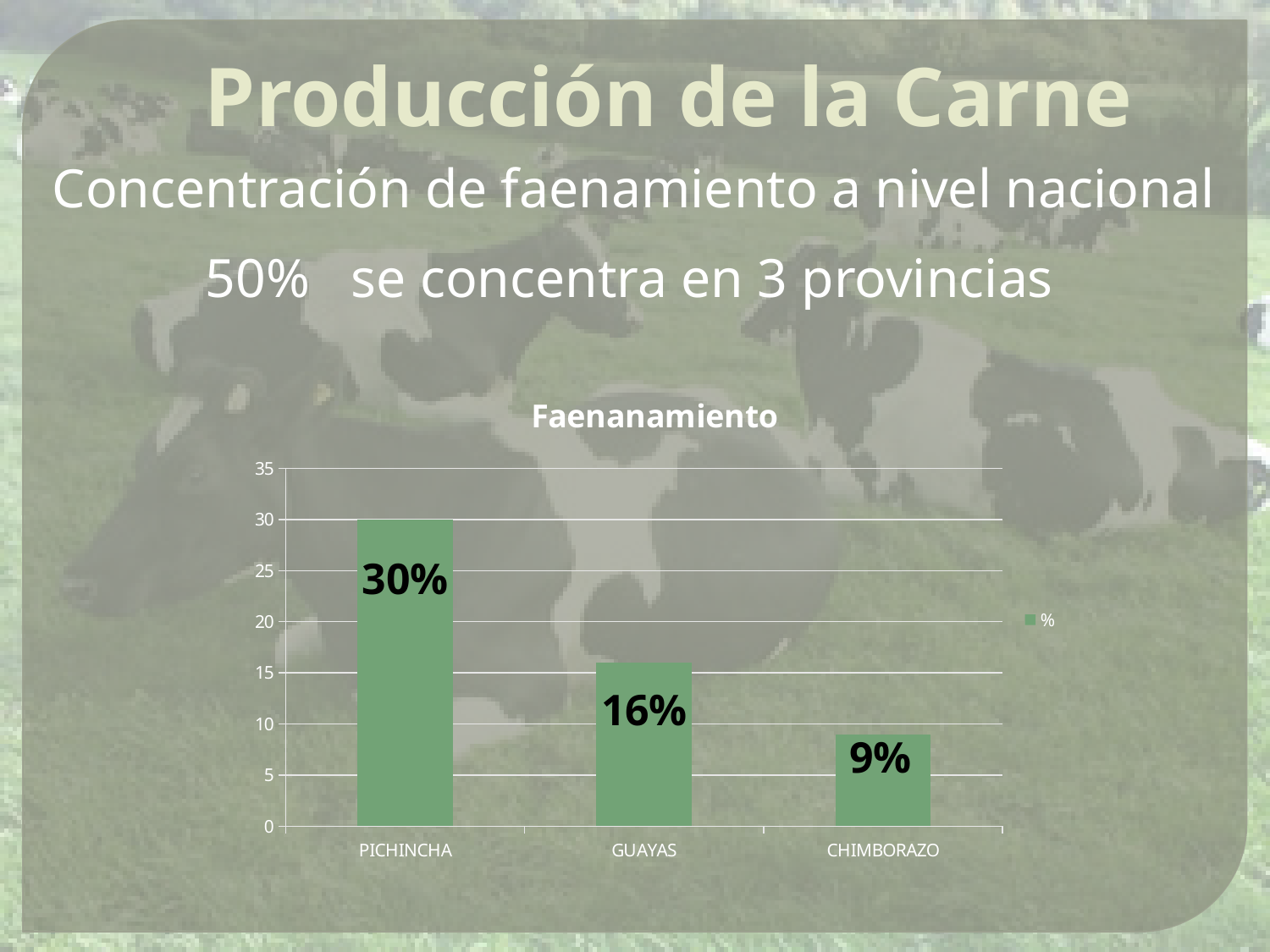
How many provinces are shown in the chart? 3 Do the values rise or fall from left to right across the provinces? fall Which province has the lowest value? CHIMBORAZO What kind of chart is shown? bar chart What is the title of the chart? Faenanamiento What is the value for CHIMBORAZO? 9% Which province has the highest value? PICHINCHA What is the difference between the values for GUAYAS and CHIMBORAZO? 7% Which is larger, the value for GUAYAS or the value for CHIMBORAZO? GUAYAS What is the value for GUAYAS? 16% What is the value for PICHINCHA? 30% What is the difference between the values for PICHINCHA and GUAYAS? 14%